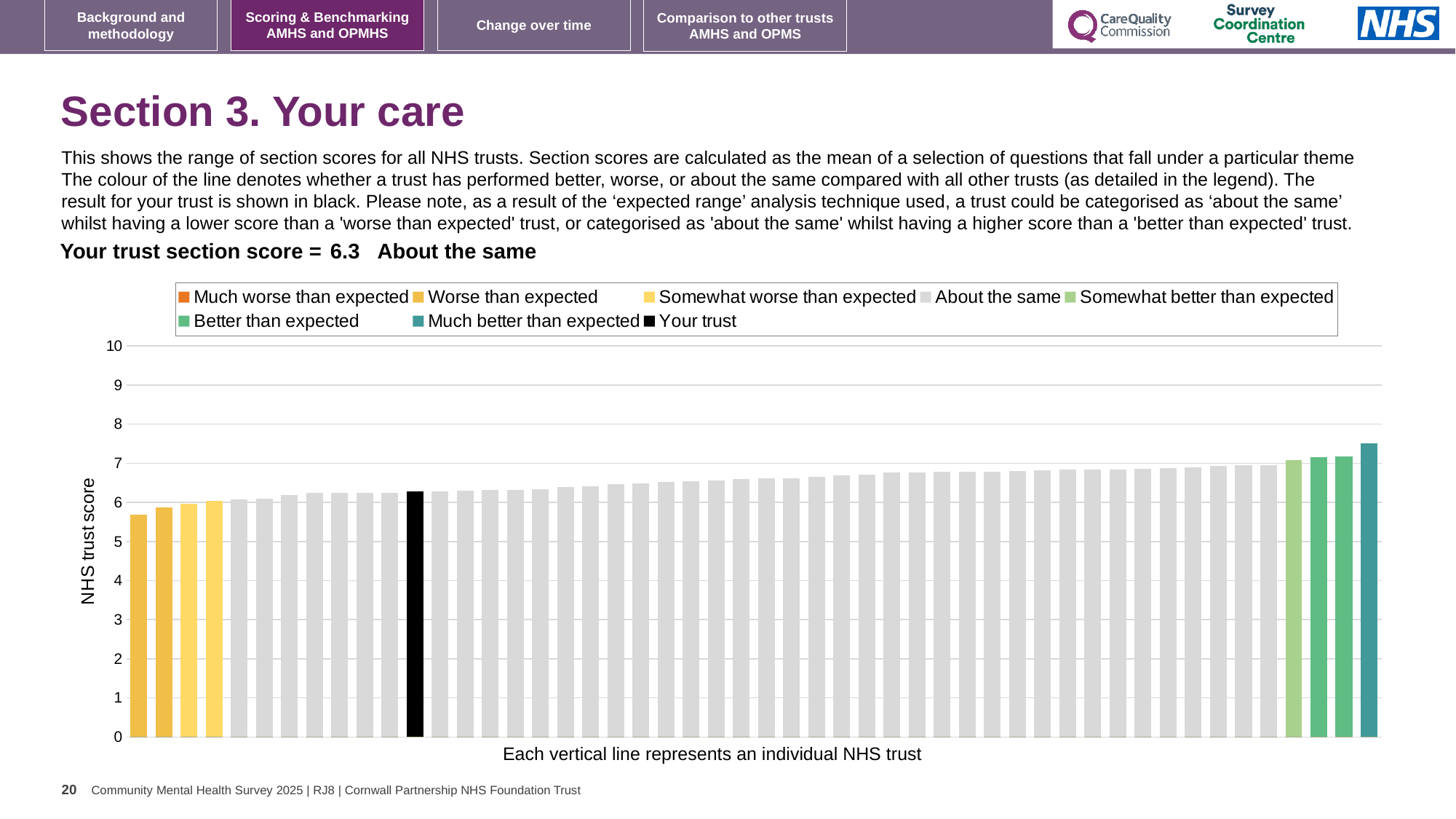
What kind of chart is shown on the slide? bar chart What is the section score for your trust shown on the slide? 6.3 Is the value of the tallest bar greater or less than 7? greater Which legend category does the tallest bar belong to? Much better than expected Do the bar values rise or fall from left to right along the x axis? rise What is the label on the vertical axis of the chart? NHS trust score How many entries does the chart legend list? 8 What colour is the bar representing your trust? black How is your trust categorised compared with other trusts? About the same How many bars are coloured as 'Much better than expected'? 1 Is the value of the leftmost (shortest) bar greater or less than 6? less Is the value for your trust (the black bar) greater or less than 5? greater